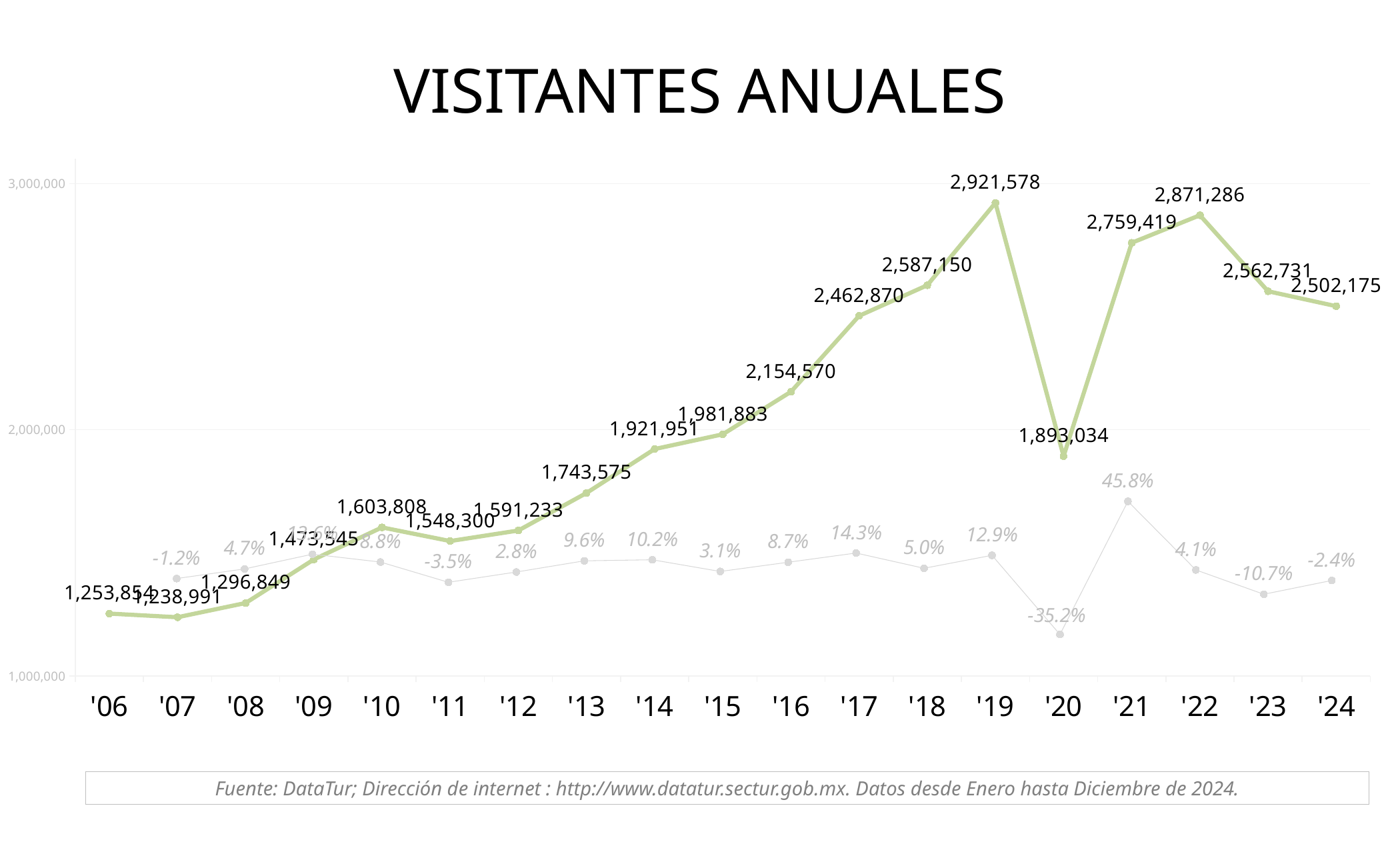
What is the number of annual visitors for '19? 2,921,578 What is the title of the chart? VISITANTES ANUALES Which year has the lowest number of annual visitors? '07 Which year has more annual visitors, '21 or '22? '22 How many years are plotted along the x axis? 19 What is the number of annual visitors for '20? 1,893,034 What is the number of annual visitors for '24? 2,502,175 What is the difference in annual visitors between '22 and '23? 308,555 What percentage change is shown for '21? 45.8% What type of chart is shown on the slide? line chart Which year has the highest number of annual visitors? '19 What percentage change is shown for '20? -35.2%